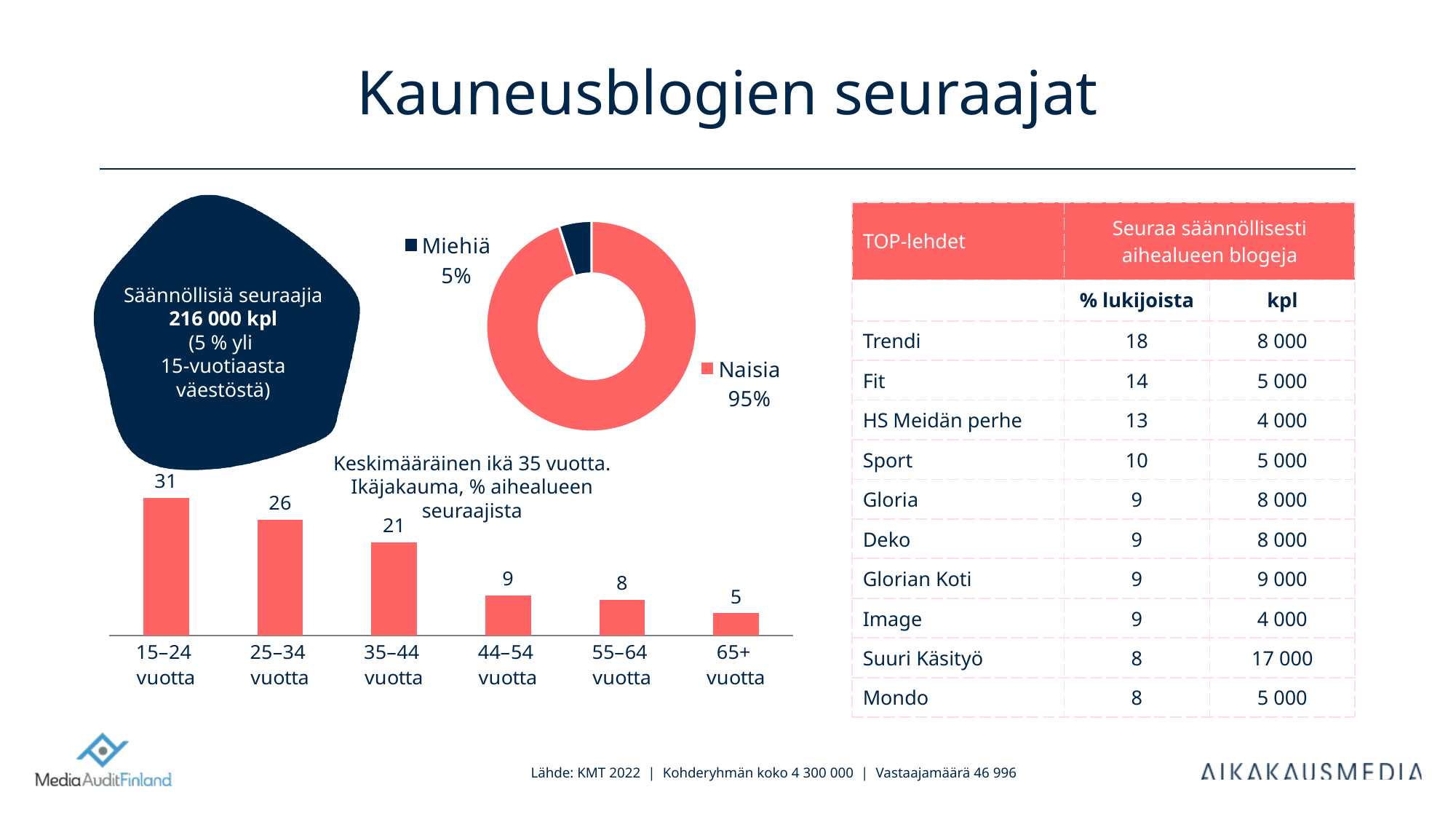
In the donut chart of gender, what share is Naisia? 95% In the bar chart of age distribution (Ikäjakauma), which age group has the lowest value? 65+ vuotta In the bar chart of age distribution (Ikäjakauma), do the values rise or fall from the youngest to the oldest age group? fall In the bar chart of age distribution (Ikäjakauma), what is the difference between the values for 15–24 vuotta and 25–34 vuotta? 5 In the donut chart of gender, what share is Miehiä? 5% How many age groups are shown in the bar chart of age distribution (Ikäjakauma)? 6 In the bar chart of age distribution (Ikäjakauma), what is the value for 35–44 vuotta? 21 In the bar chart of age distribution (Ikäjakauma), what is the value for 15–24 vuotta? 31 In the bar chart of age distribution (Ikäjakauma), which age group has the highest value? 15–24 vuotta In the bar chart of age distribution (Ikäjakauma), which is larger: the value for 44–54 vuotta or 55–64 vuotta? 44–54 vuotta What kind of chart is used to show the age distribution (Ikäjakauma) on the slide? bar chart How many categories does the legend of the donut chart of gender list? 2